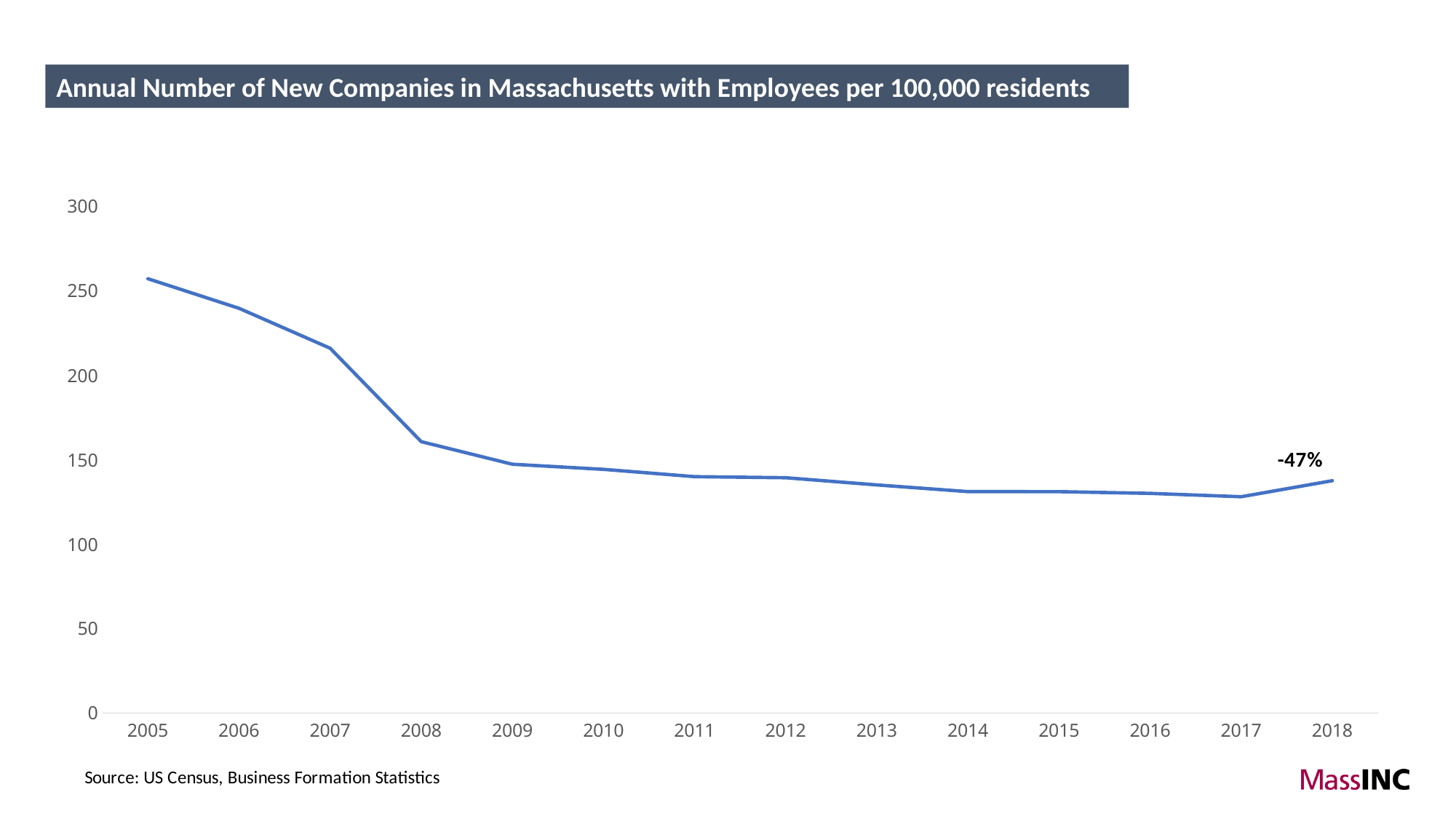
Which year has the highest value on the chart? 2005 Is the value for 2008 greater or less than 150? greater How many years are plotted along the x axis? 14 Is the value for 2007 greater or less than 200? greater Which year has the larger value, 2007 or 2008? 2007 Is the value for 2018 greater or less than 150? less Which year has the larger value, 2017 or 2018? 2018 What percentage change is annotated at the end of the line near 2018? -47% What kind of chart is shown on the slide? Line chart Overall, do the values rise or fall from 2005 to 2018? Fall What is the title of the chart? Annual Number of New Companies in Massachusetts with Employees per 100,000 residents